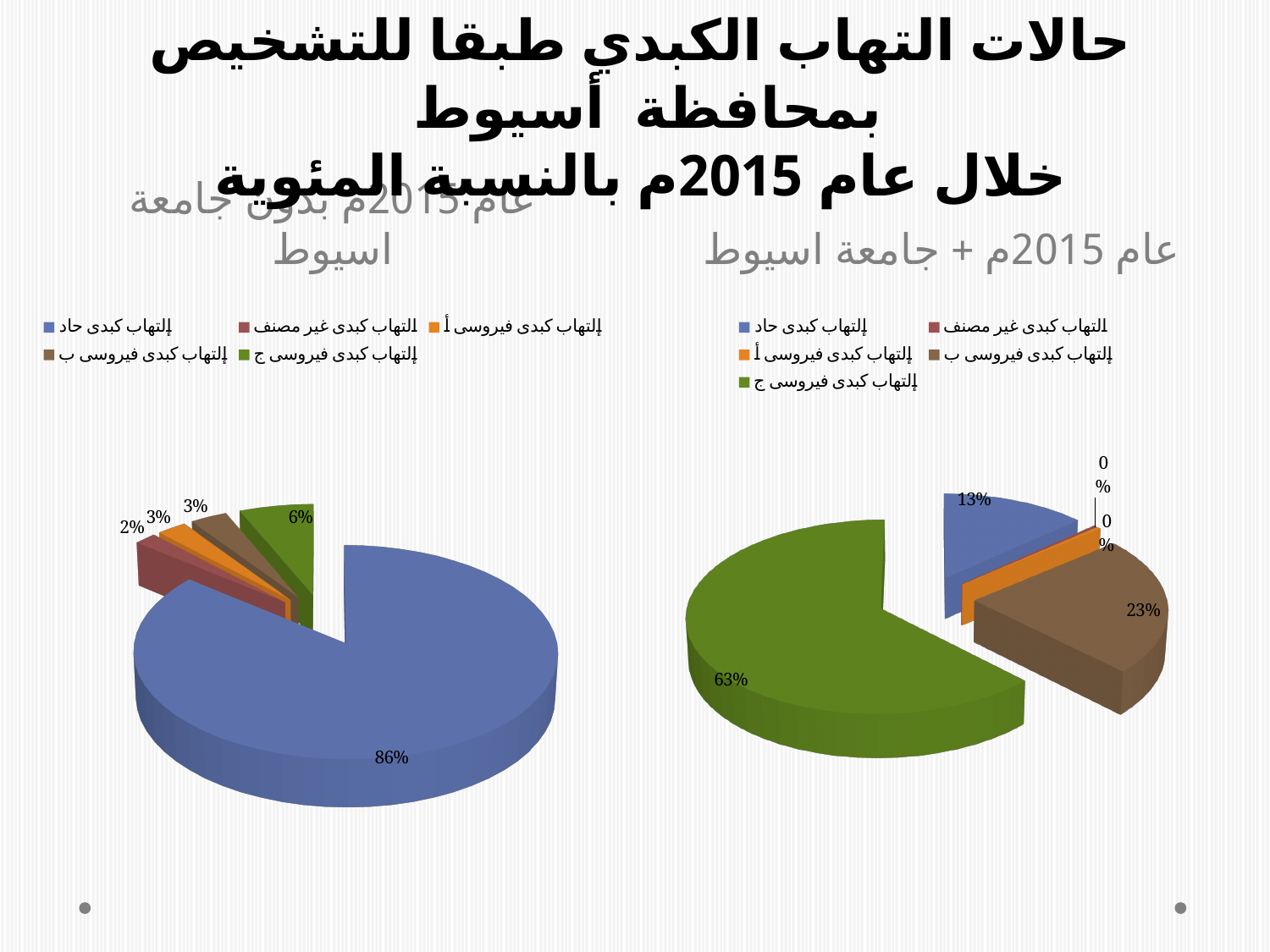
In the chart titled "عام 2015م بدون جامعة اسيوط", what percentage is shown for إلتهاب كبدى حاد? 86% In the chart titled "عام 2015م + جامعة اسيوط", what percentage is shown for إلتهاب كبدى فيروسى ج? 63% In the chart titled "عام 2015م بدون جامعة اسيوط", which category has the largest share? إلتهاب كبدى حاد What type of chart is the chart titled "عام 2015م + جامعة اسيوط"? Pie chart In the chart titled "عام 2015م بدون جامعة اسيوط", what percentage is shown for إلتهاب كبدى فيروسى ج? 6% How many categories does the legend of the chart titled "عام 2015م بدون جامعة اسيوط" list? 5 In the chart titled "عام 2015م + جامعة اسيوط", what percentage is shown for إلتهاب كبدى فيروسى ب? 23% In the chart titled "عام 2015م + جامعة اسيوط", which category has the largest share? إلتهاب كبدى فيروسى ج In the chart titled "عام 2015م بدون جامعة اسيوط", which is larger: إلتهاب كبدى فيروسى ج or التهاب كبدى غير مصنف? إلتهاب كبدى فيروسى ج In the chart titled "عام 2015م + جامعة اسيوط", what percentage is shown for إلتهاب كبدى حاد? 13% In the chart titled "عام 2015م بدون جامعة اسيوط", what percentage is shown for التهاب كبدى غير مصنف? 2% In the chart titled "عام 2015م + جامعة اسيوط", what is the difference in percentage points between إلتهاب كبدى فيروسى ج and إلتهاب كبدى فيروسى ب? 40